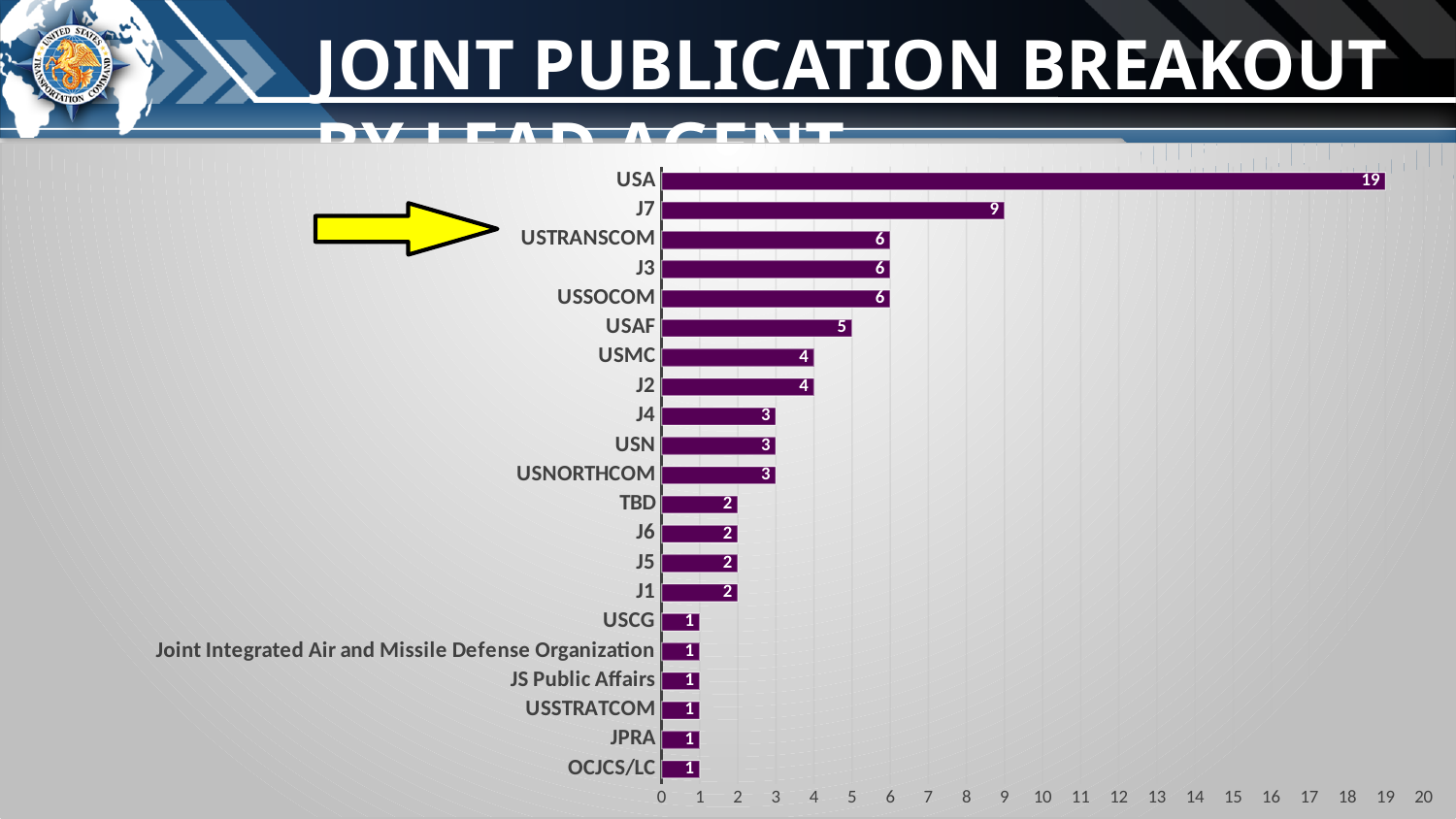
How many categories are shown on the chart? 21 What is the difference between the values for USA and J7? 10 What kind of chart is shown on the slide? bar chart Which category has the highest value? USA What is the difference between the values for J7 and USMC? 5 What colour are the bars on the chart? purple Is the value for USA greater or less than 15? greater What is the value for USAF? 5 Which is larger, the value for USAF or the value for J2? USAF What is the value for USTRANSCOM? 6 What is the value for USNORTHCOM? 3 What is the value for USA? 19